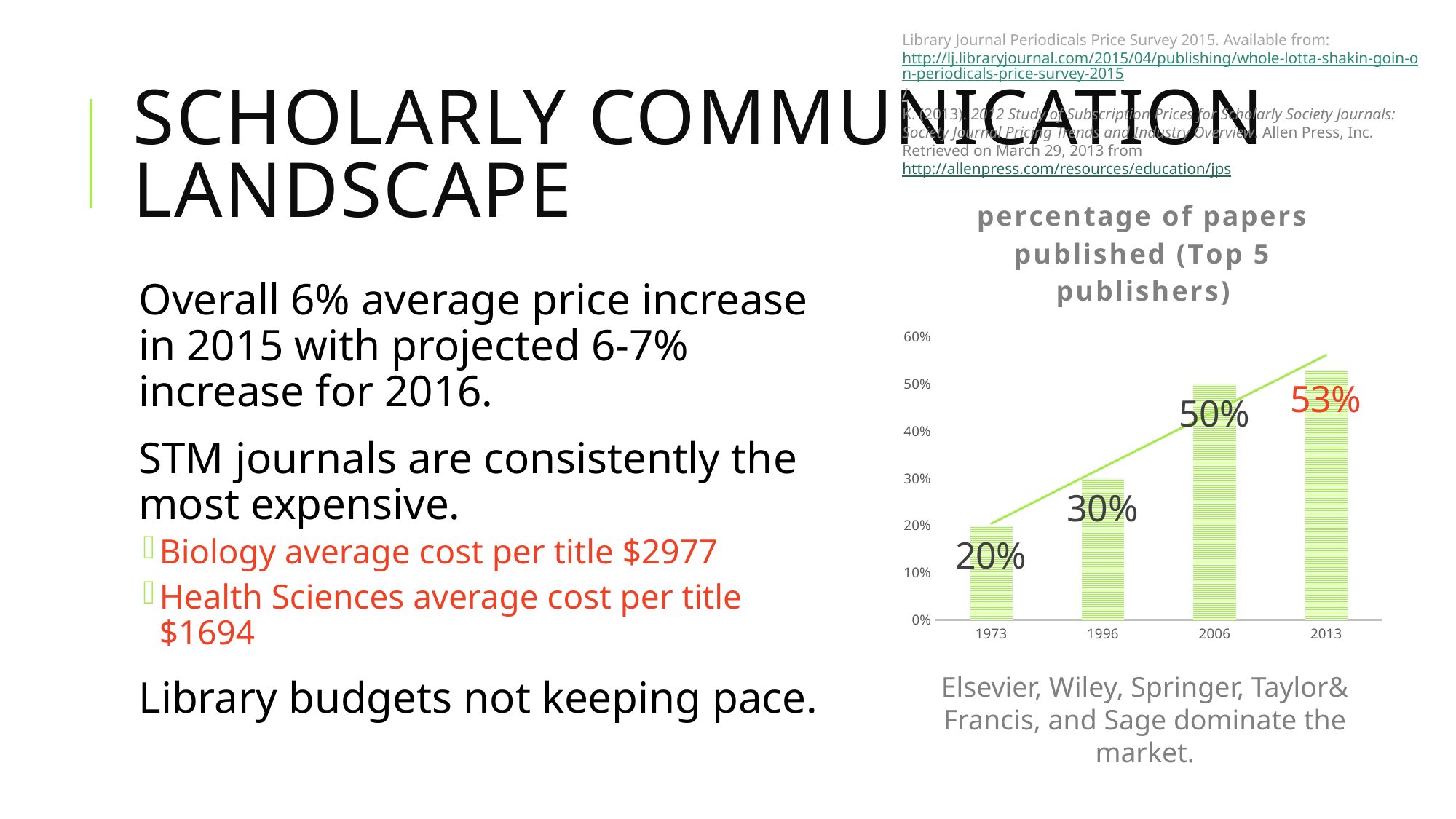
How many years are shown on the x axis of the chart? 4 What is the percentage of papers published by the top 5 publishers in 1996? 30% What is the percentage of papers published by the top 5 publishers in 1973? 20% Which year has the highest percentage of papers published by the top 5 publishers? 2013 Which year has a larger value, 1996 or 2006? 2006 What is the percentage of papers published by the top 5 publishers in 2006? 50% What kind of chart is used to show the percentage of papers published by the top 5 publishers? Bar chart What is the percentage of papers published by the top 5 publishers in 2013? 53% What is the difference in percentage points between 2006 and 1996? 20 Do the values rise or fall from 1973 to 2013? Rise Which year has the lowest percentage of papers published by the top 5 publishers? 1973 What is the difference in percentage points between 2013 and 1973? 33